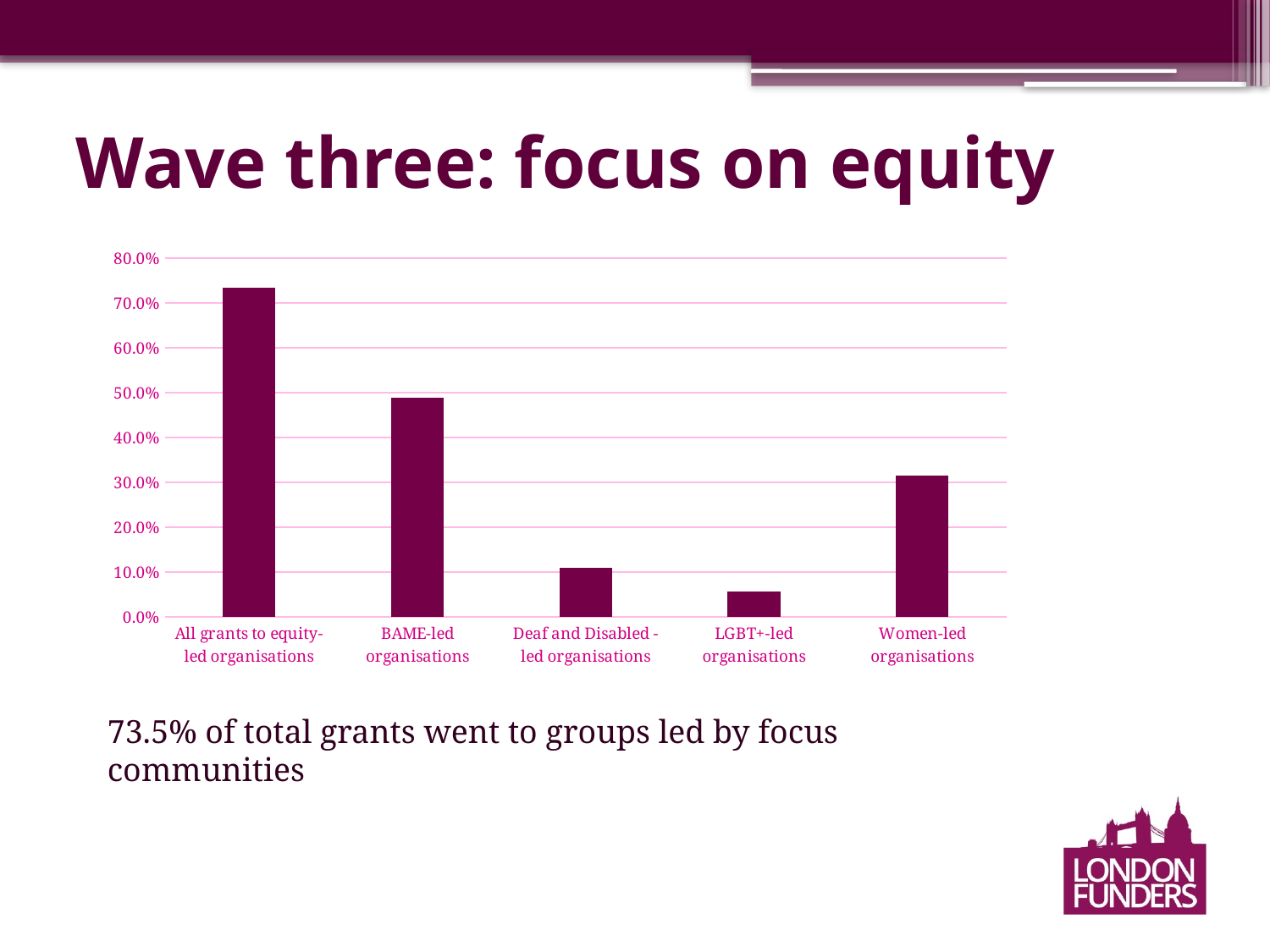
Which is larger: the value for BAME-led organisations or the value for Women-led organisations? BAME-led organisations How many categories are shown on the x axis of the chart? 5 Is the value for Women-led organisations greater or less than 20.0%? greater Is the value for All grants to equity-led organisations greater or less than 70.0%? greater Is the value for LGBT+-led organisations greater or less than 10.0%? less Which category has the lowest bar in the chart? LGBT+-led organisations What is the highest value shown on the chart's y axis? 80.0% Which category has the highest bar in the chart? All grants to equity-led organisations Which is larger: the value for Deaf and Disabled-led organisations or the value for LGBT+-led organisations? Deaf and Disabled-led organisations What kind of chart is shown on the slide? bar chart